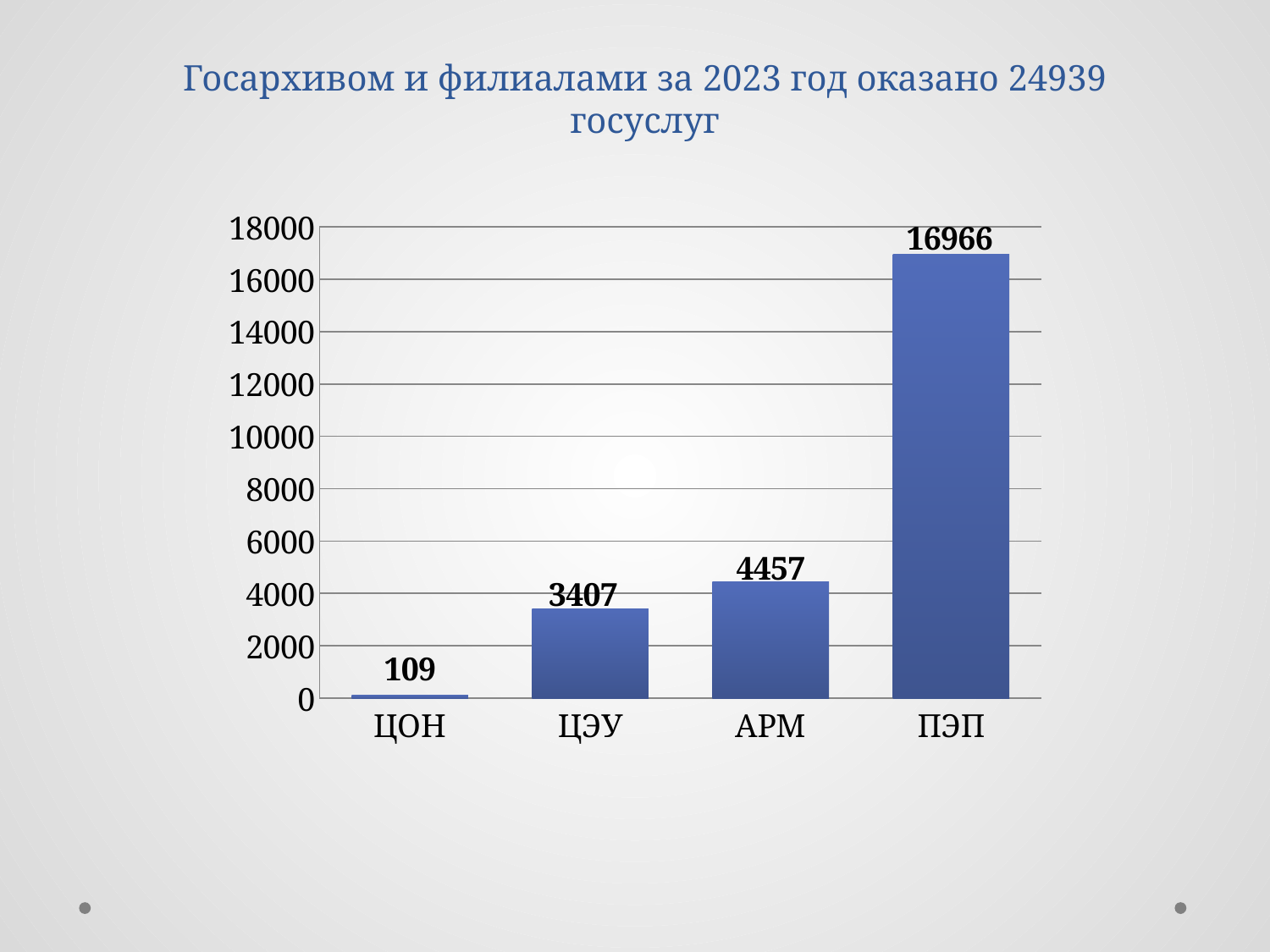
What is the difference between the values for ПЭП and АРМ? 12509 What is the value for ПЭП? 16966 Which category has the highest value? ПЭП What is the value for ЦОН? 109 How many categories are shown on the x axis? 4 What is the value for АРМ? 4457 Which is larger, the value for ЦЭУ or the value for АРМ? АРМ What is the value for ЦЭУ? 3407 Is the value for ПЭП greater or less than 16000? greater What is the difference between the values for АРМ and ЦЭУ? 1050 What kind of chart is shown on the slide? bar chart Which category has the lowest value? ЦОН